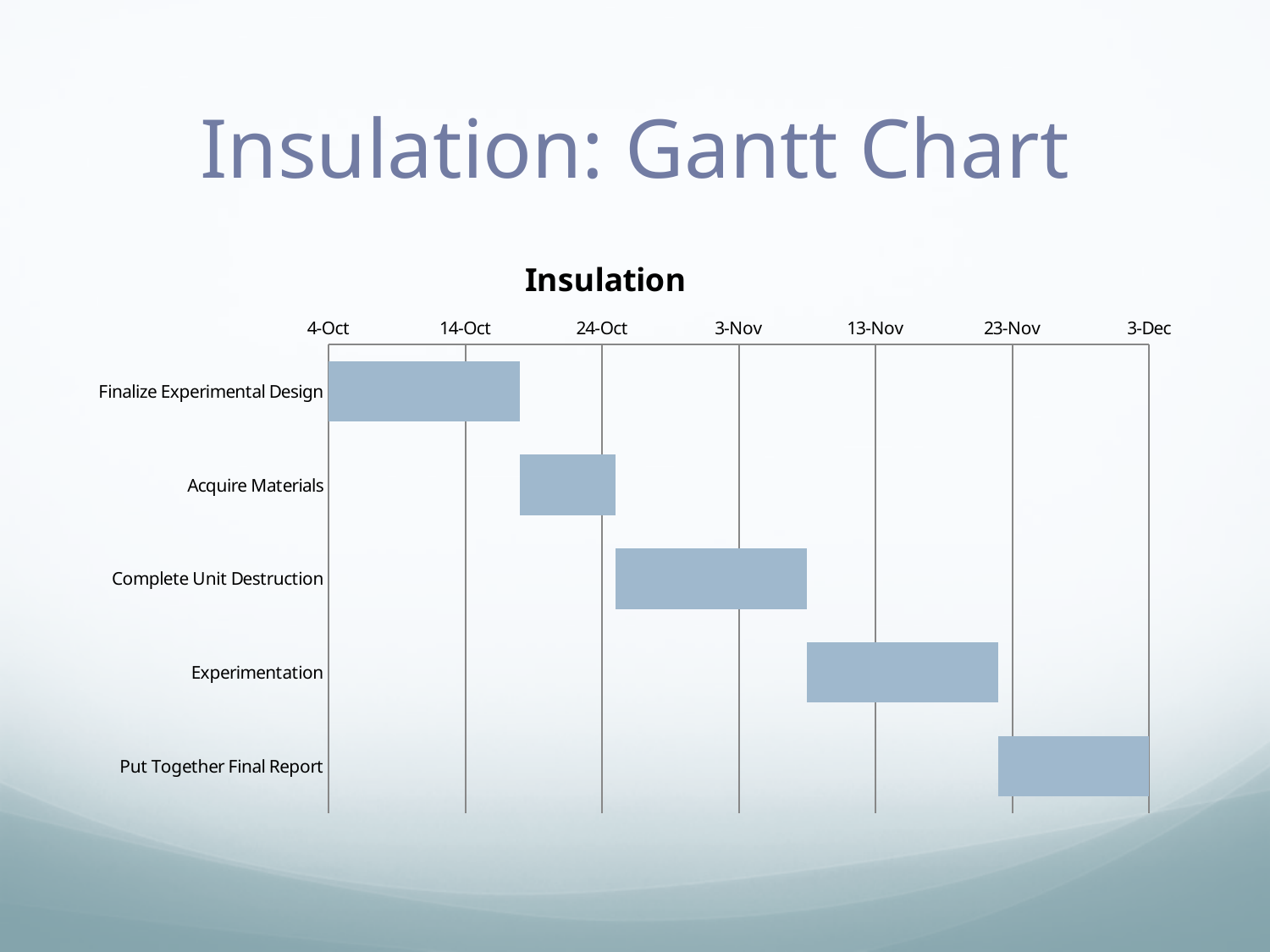
Which task has the shortest bar in the chart? Acquire Materials Does the bar for Acquire Materials start before or after 14-Oct? after Which task starts later, Experimentation or Acquire Materials? Experimentation What is the earliest date label shown on the horizontal axis? 4-Oct What is the title of the chart? Insulation Does the bar for Experimentation end before or after 23-Nov? before Which task is scheduled first in the chart? Finalize Experimental Design On what date does the bar for Put Together Final Report end? 3-Dec How many tasks are listed on the vertical axis of the chart? 5 What kind of chart is shown on the slide? Bar chart (Gantt chart) On what date does the bar for Finalize Experimental Design begin? 4-Oct Does the bar for Complete Unit Destruction start before or after 24-Oct? after